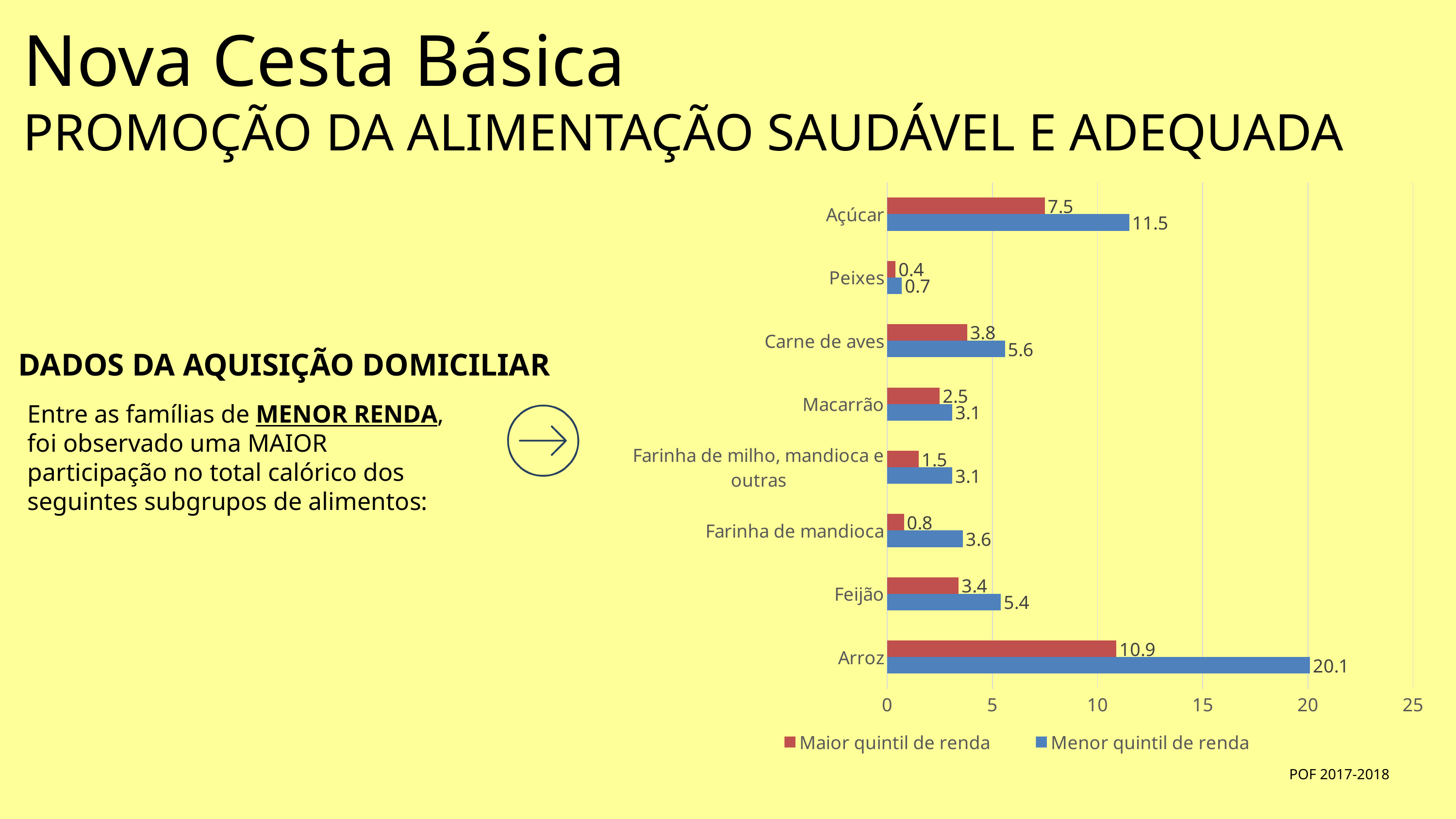
What is the value for Açúcar in the Maior quintil de renda series? 7.5 Which is larger for Feijão: the Maior quintil de renda value or the Menor quintil de renda value? Menor quintil de renda Is the Menor quintil de renda value for Açúcar greater or less than 10? greater Which category has the lowest value in the Maior quintil de renda series? Peixes How many series does the legend list? 2 What kind of chart is shown on the slide? Bar chart Which category has the highest value in the Menor quintil de renda series? Arroz How many food categories are shown on the chart? 8 What is the difference between the Menor quintil de renda and Maior quintil de renda values for Arroz? 9.2 What is the value for Farinha de mandioca in the Menor quintil de renda series? 3.6 What is the difference between the Menor quintil de renda and Maior quintil de renda values for Açúcar? 4.0 What is the value for Arroz in the Menor quintil de renda series? 20.1